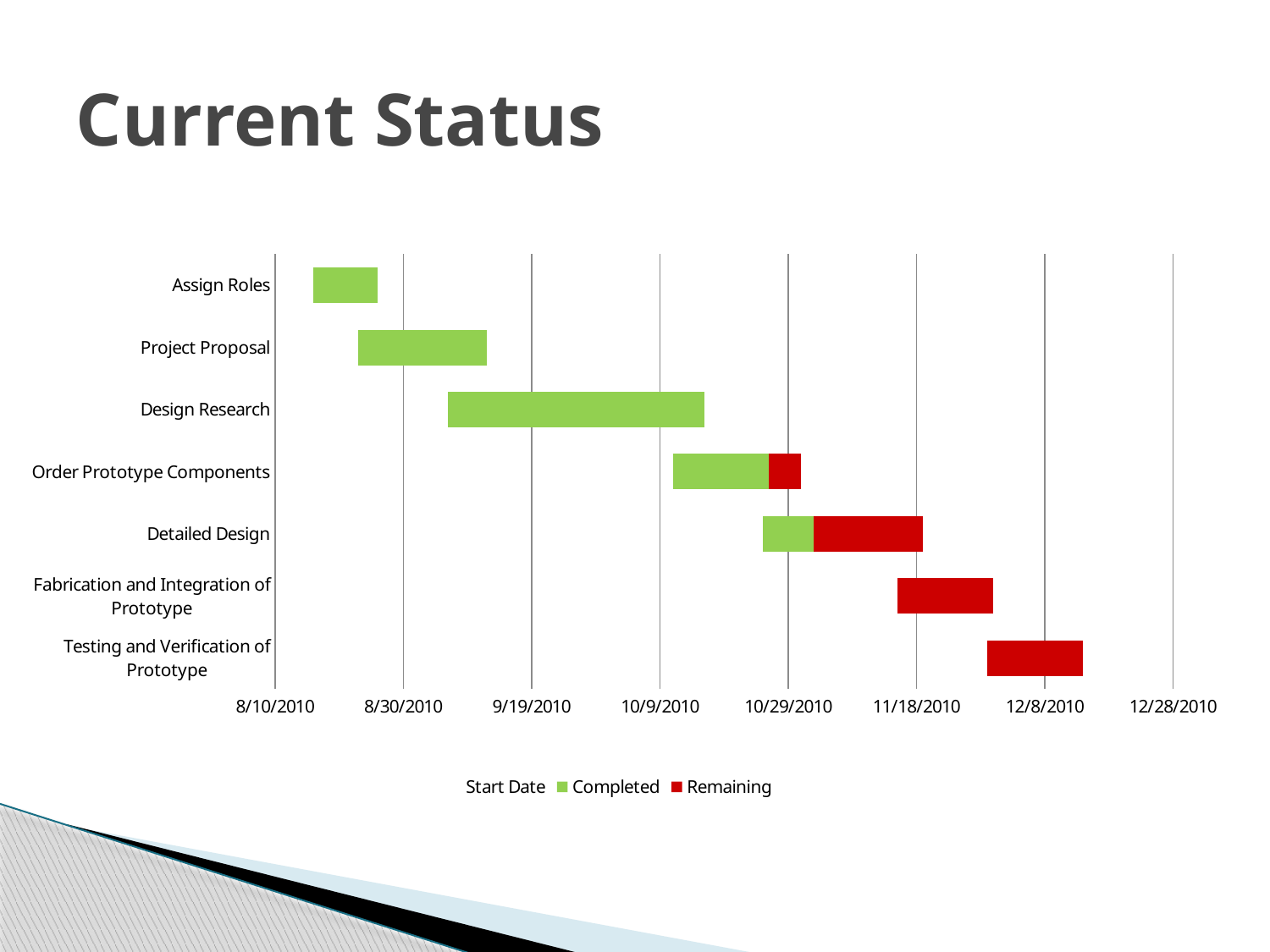
How many tasks are listed on the vertical axis of the chart? 7 How many tasks show no Completed (green) portion at all? 2 What is the title of the slide containing the chart? Current Status Which task has the longest Completed (green) bar? Design Research Which task ends latest on the chart? Testing and Verification of Prototype How many tasks show a Remaining (red) portion? 4 What kind of chart is shown on the slide? bar chart What colour represents the Remaining series in the chart? red Which task starts earlier, Order Prototype Components or Detailed Design? Order Prototype Components Which task starts earliest on the chart? Assign Roles Going down the list of tasks, do the start dates move later or earlier? later How many series does the chart legend list? 3